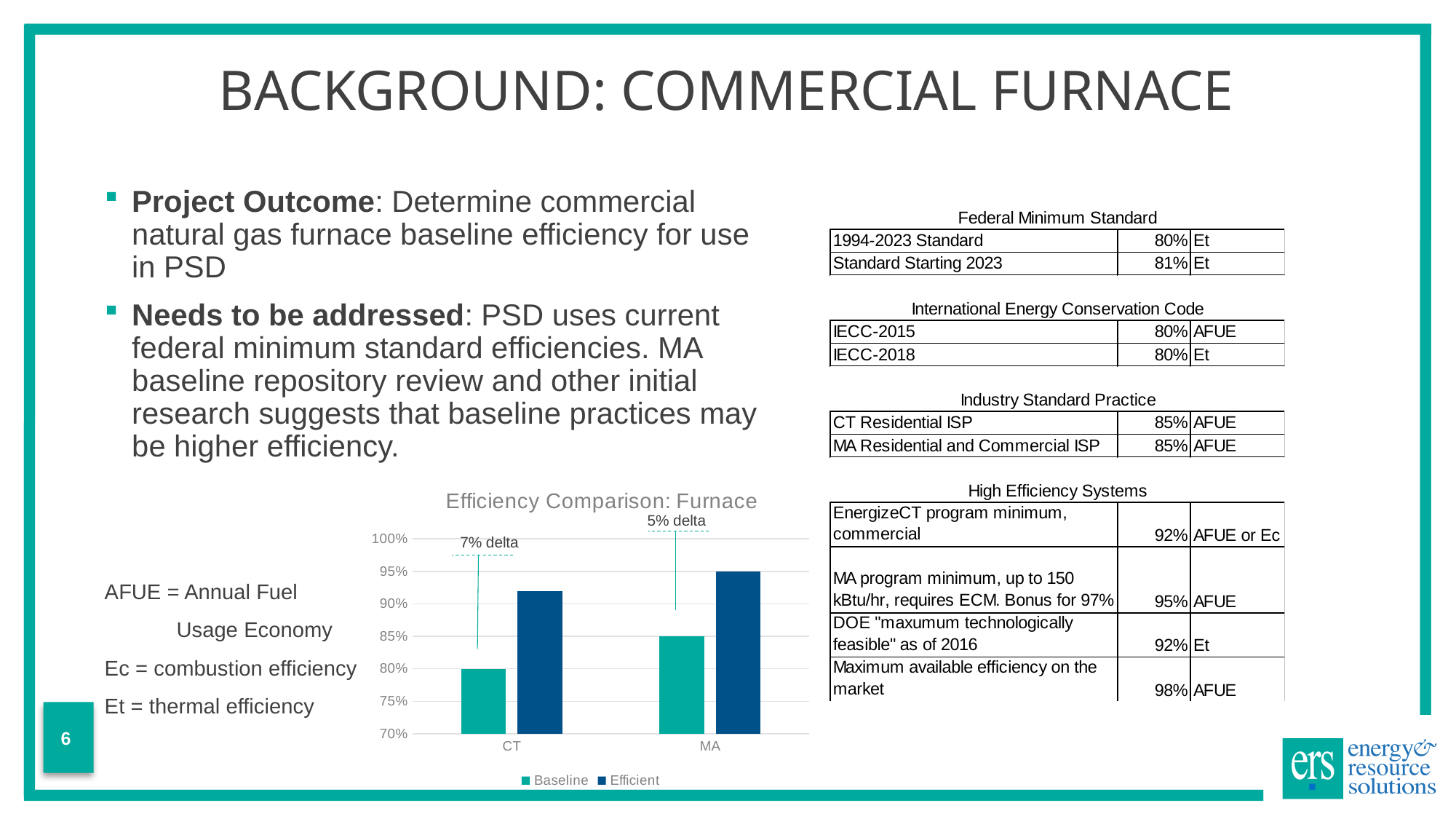
In the Efficiency Comparison: Furnace chart, does the Baseline value rise or fall from CT to MA? rise In the Efficiency Comparison: Furnace chart, what is the Baseline value for MA? 85% How many series does the legend of the Efficiency Comparison: Furnace chart list? 2 What is the title of the chart on the slide? Efficiency Comparison: Furnace How many categories are shown on the x axis of the Efficiency Comparison: Furnace chart? 2 In the Efficiency Comparison: Furnace chart, what is the Baseline value for CT? 80% In the Efficiency Comparison: Furnace chart, which state has the higher Baseline value, CT or MA? MA In the Efficiency Comparison: Furnace chart, which category has the highest Efficient bar? MA What annotation text is shown above the CT bars in the Efficiency Comparison: Furnace chart? 7% delta In the Efficiency Comparison: Furnace chart, what is the Efficient value for MA? 95% In the Efficiency Comparison: Furnace chart, is the Efficient value for CT greater or less than 90%? greater What kind of chart is the Efficiency Comparison: Furnace chart? bar chart